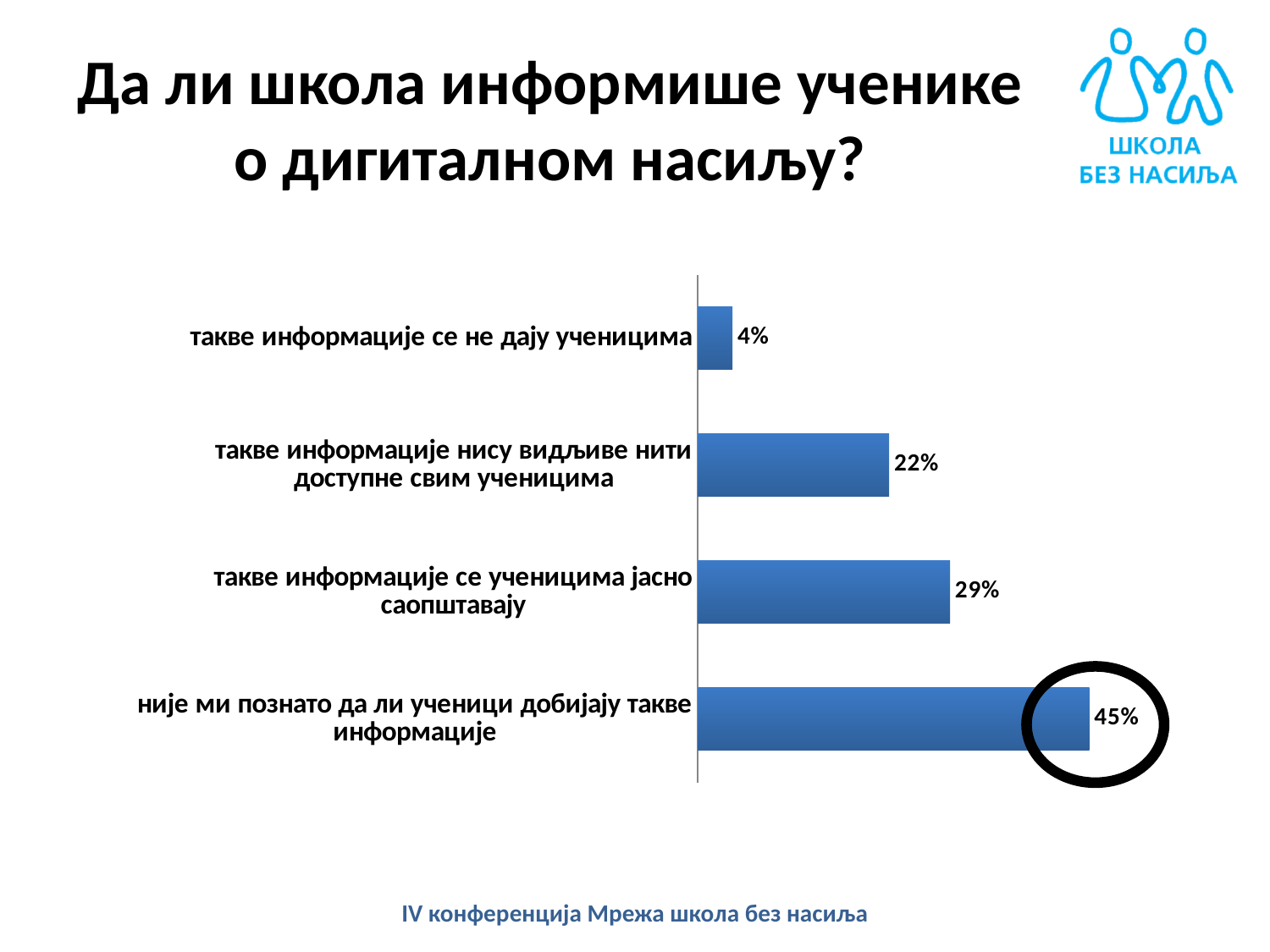
How many categories are shown in the chart? 4 What is the difference between the values for "такве информације нису видљиве нити доступне свим ученицима" and "такве информације се не дају ученицима"? 18% What is the value for "није ми познато да ли ученици добијају такве информације"? 45% What is the value for "такве информације се не дају ученицима"? 4% Which is larger: the value for "такве информације се ученицима јасно саопштавају" or the value for "такве информације нису видљиве нити доступне свим ученицима"? такве информације се ученицима јасно саопштавају What is the value for "такве информације нису видљиве нити доступне свим ученицима"? 22% What is the value for "такве информације се ученицима јасно саопштавају"? 29% What is the difference between the values for "није ми познато да ли ученици добијају такве информације" and "такве информације се ученицима јасно саопштавају"? 16% What kind of chart is shown on the slide? bar chart Which category has the highest value? није ми познато да ли ученици добијају такве информације Which bar's data label is circled on the slide? није ми познато да ли ученици добијају такве информације (45%) Which category has the lowest value? такве информације се не дају ученицима